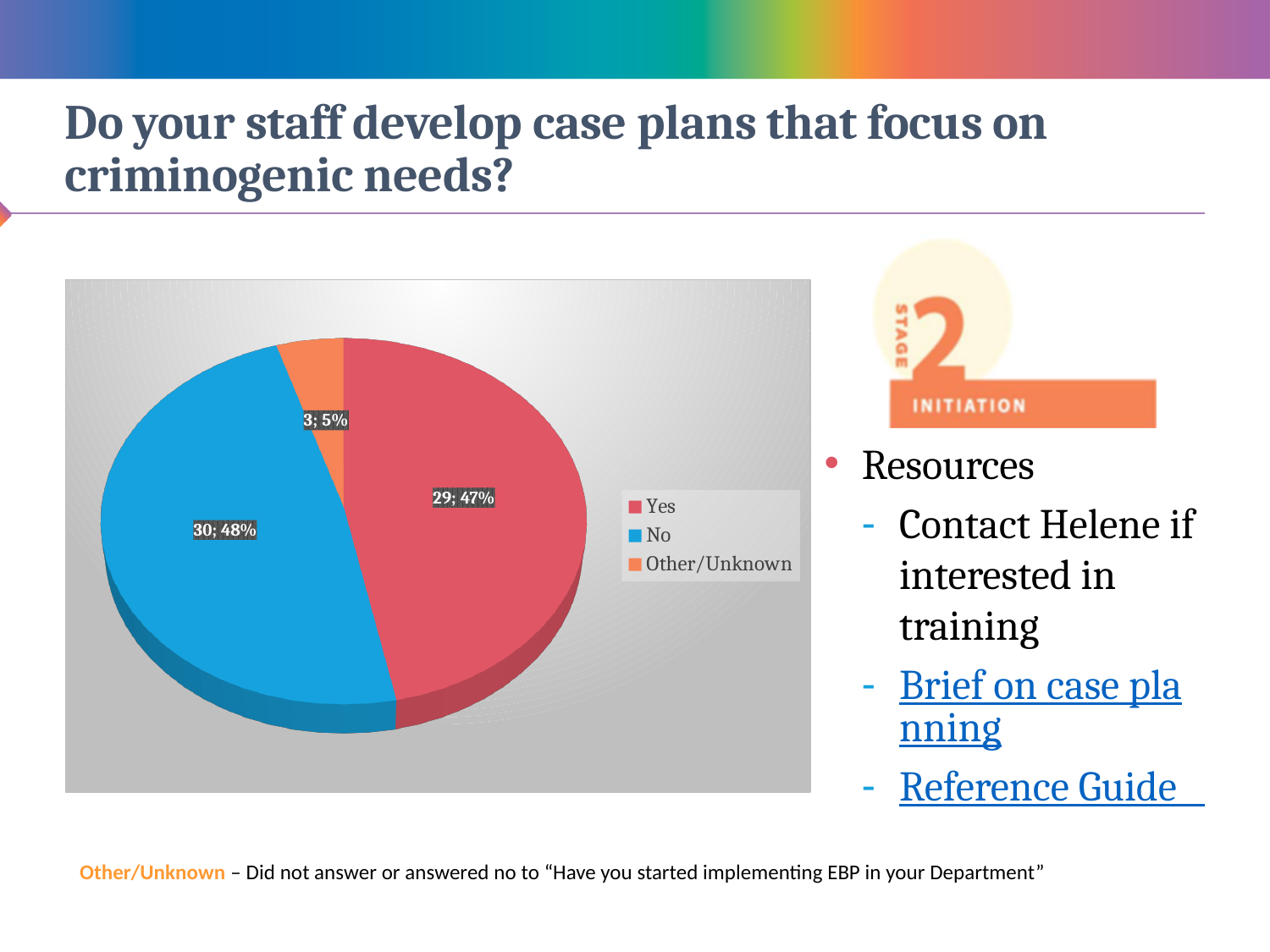
Which colour represents "Other/Unknown" in the pie chart legend? orange What kind of chart is shown on the slide? pie chart What is the difference in count between the "Yes" and "Other/Unknown" slices? 26 How many responses are in the "Other/Unknown" slice? 3 What percentage share does the "Yes" slice have? 47% How many categories does the pie chart show? 3 What percentage of the pie chart is the "No" slice? 48% Which category has the smallest slice of the pie chart? Other/Unknown What is the difference in count between the "No" and "Yes" slices? 1 What is the total number of responses across all slices of the pie chart? 62 Which category has the largest slice of the pie chart? No How many responses are in the "Yes" slice of the pie chart? 29